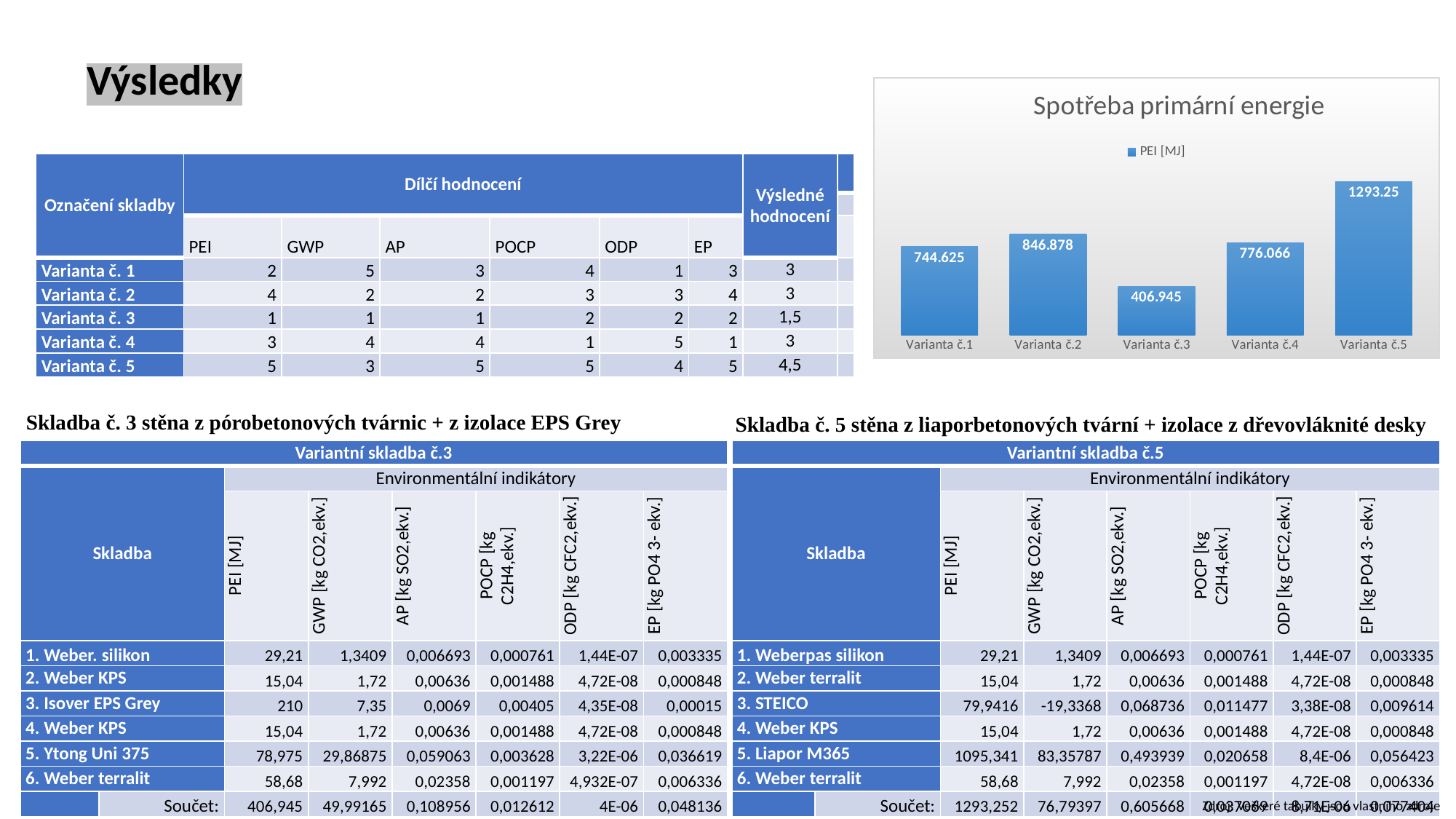
What is the value for Varianta č.1 in the chart? 744.625 What is the value for Varianta č.5 in the chart? 1293.25 What is the value for Varianta č.4 in the chart? 776.066 What is the value for Varianta č.3 in the chart? 406.945 What is the difference between the values for Varianta č.5 and Varianta č.3? 886.305 What type of chart is shown on the slide? bar chart What is the title of the chart? Spotřeba primární energie How many categories are shown in the chart? 5 Which category has the lowest value in the chart? Varianta č.3 What is the difference between the values for Varianta č.2 and Varianta č.1? 102.253 Which category has the highest value in the chart? Varianta č.5 Which is larger, the value for Varianta č.2 or Varianta č.4? Varianta č.2